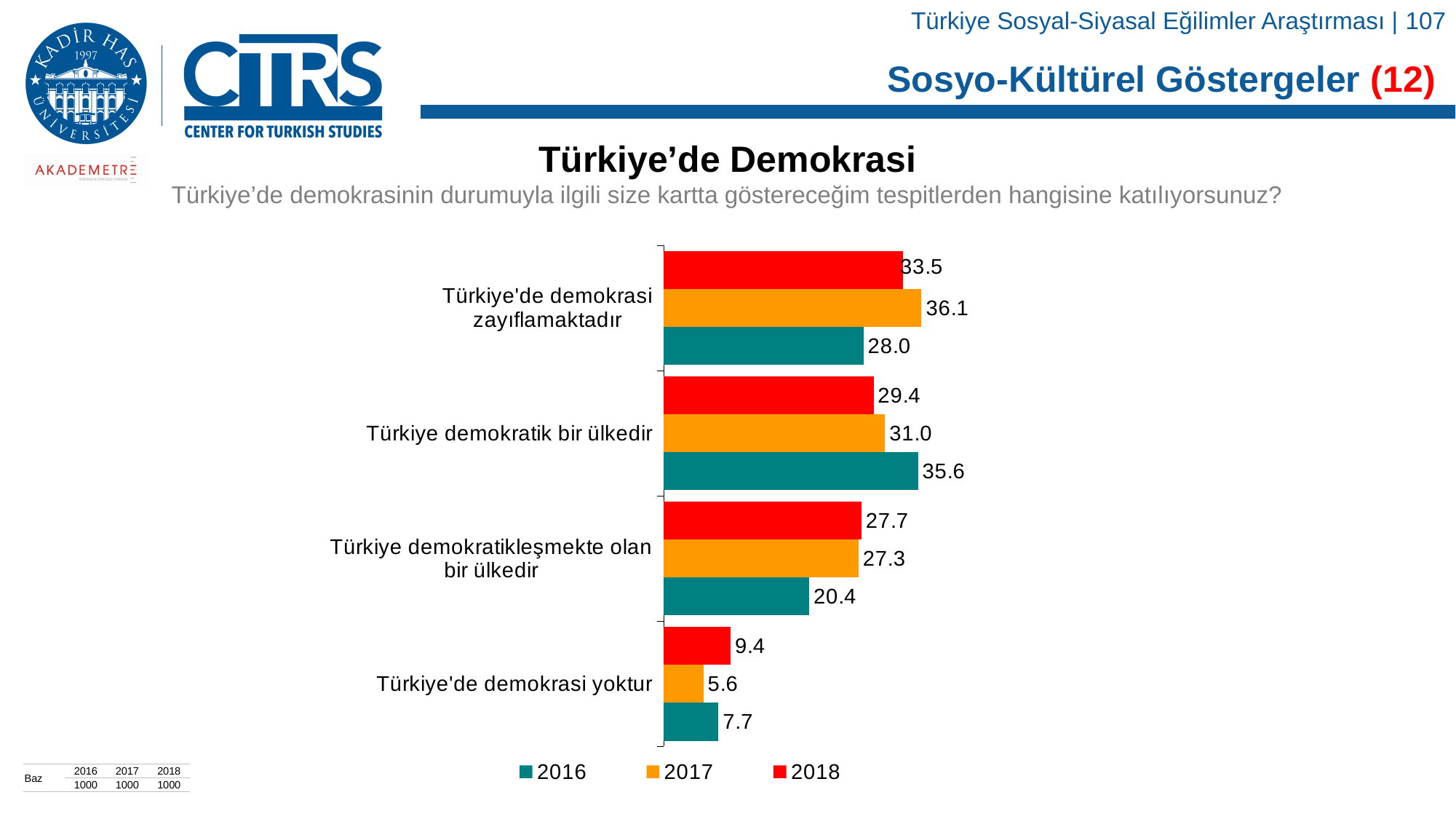
For "Türkiye demokratikleşmekte olan bir ülkedir", which year has the larger value, 2016 or 2018? 2018 Which colour represents the 2016 series in the legend? Teal What is the 2017 value for "Türkiye'de demokrasi yoktur"? 5.6 What is the 2018 value for "Türkiye'de demokrasi zayıflamaktadır"? 33.5 What kind of chart is shown on the slide? Bar chart What is the difference between the 2017 and 2016 values for "Türkiye'de demokrasi zayıflamaktadır"? 8.1 How many categories are shown on the chart? 4 Which category has the highest 2017 value? Türkiye'de demokrasi zayıflamaktadır Did the value for "Türkiye demokratik bir ülkedir" rise or fall from 2016 to 2018? Fall Which category has the lowest 2018 value? Türkiye'de demokrasi yoktur What is the 2016 value for "Türkiye demokratik bir ülkedir"? 35.6 How many series does the legend list? 3